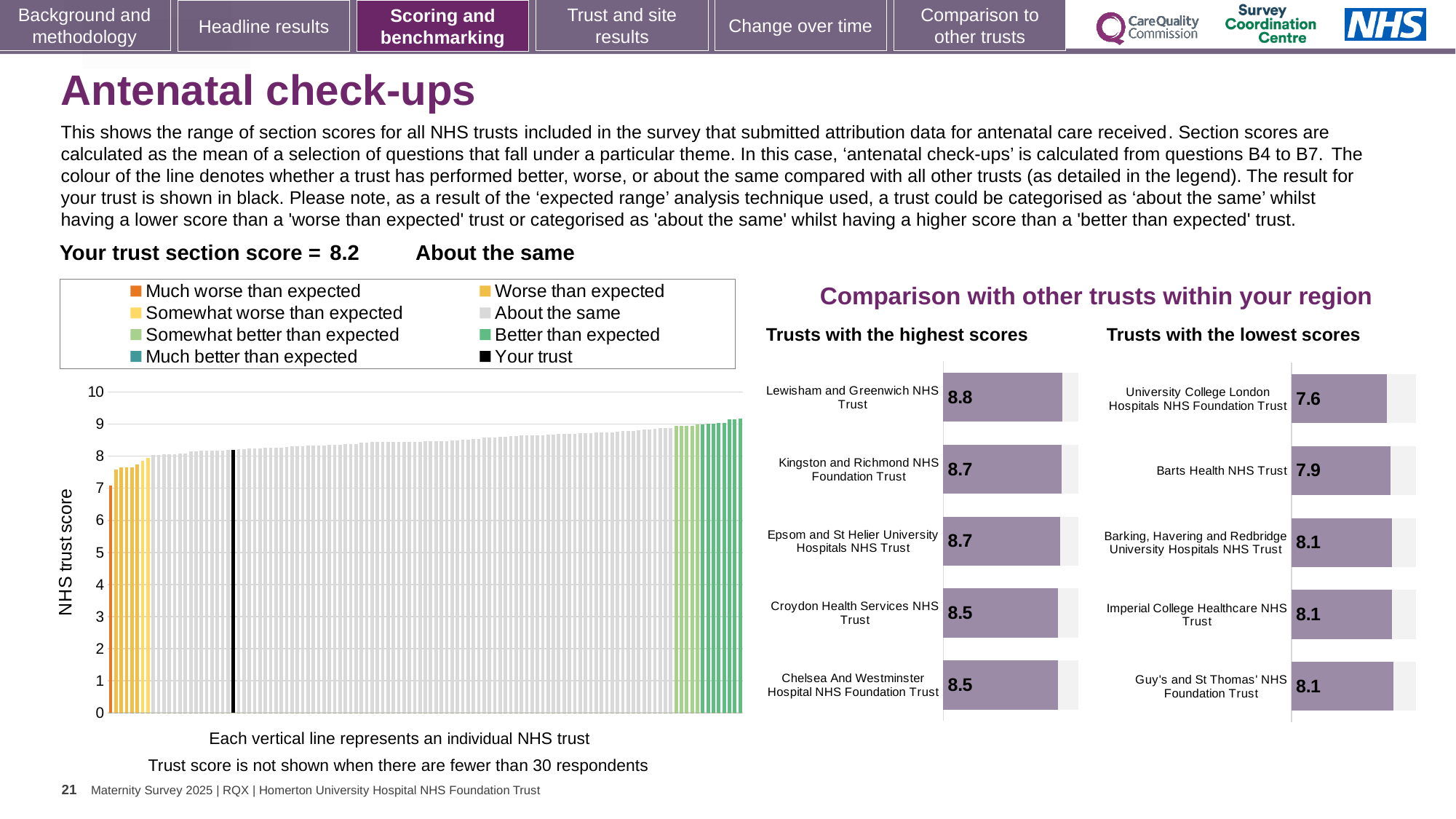
In the large chart on the left, is the value of the leftmost (orange) bar greater or less than 8? less In the 'Trusts with the highest scores' chart, what is the difference between the scores of Lewisham and Greenwich NHS Trust and Croydon Health Services NHS Trust? 0.3 How many entries does the legend above the large chart on the left list? 8 In the large chart on the left, do the trust scores rise or fall from left to right? rise What is the section score for your trust shown on the slide? 8.2 In the 'Trusts with the highest scores' chart, what is the score for Kingston and Richmond NHS Foundation Trust? 8.7 In the 'Trusts with the lowest scores' chart, which trust has the lowest score? University College London Hospitals NHS Foundation Trust In the 'Trusts with the highest scores' chart, which trust has the highest score? Lewisham and Greenwich NHS Trust What kind of chart is the large chart on the left showing NHS trust scores? bar chart In the large chart on the left, what is the label on the vertical axis? NHS trust score In the 'Trusts with the lowest scores' chart, how many trusts are shown? 5 In the 'Trusts with the lowest scores' chart, which has the larger score: Barts Health NHS Trust or University College London Hospitals NHS Foundation Trust? Barts Health NHS Trust